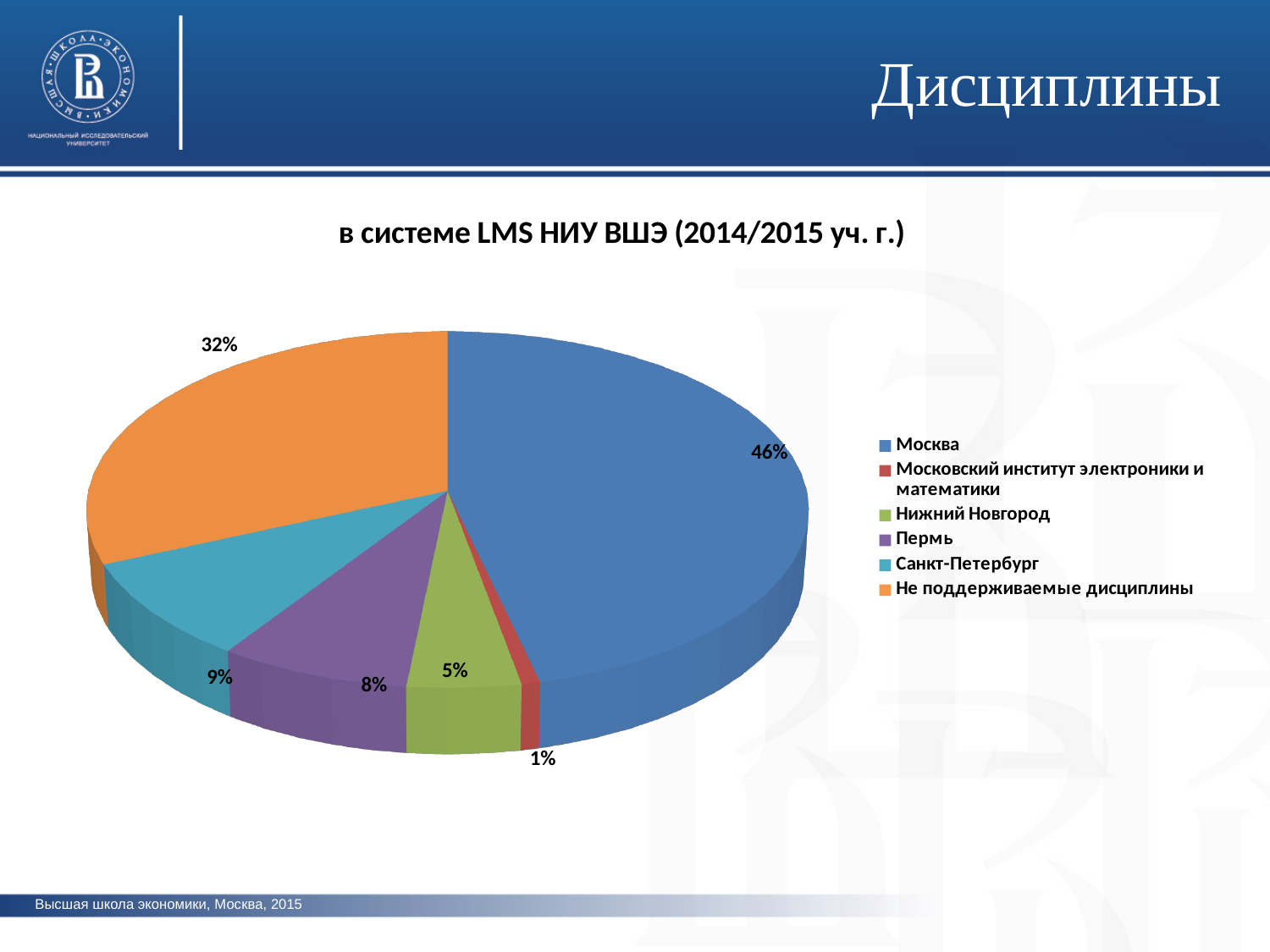
What share of the pie does Санкт-Петербург have? 9% What share of the pie does Не поддерживаемые дисциплины have? 32% Which category has the smallest slice of the pie? Московский институт электроники и математики Which is larger, the share of Санкт-Петербург or the share of Пермь? Санкт-Петербург Which category has the largest slice of the pie? Москва What share of the pie does Пермь have? 8% What share of the pie does Московский институт электроники и математики have? 1% What kind of chart is shown on the slide? pie chart What share of the pie does Москва have? 46% What is the difference between the shares of Москва and Не поддерживаемые дисциплины? 14% What share of the pie does Нижний Новгород have? 5% How many categories does the legend list? 6